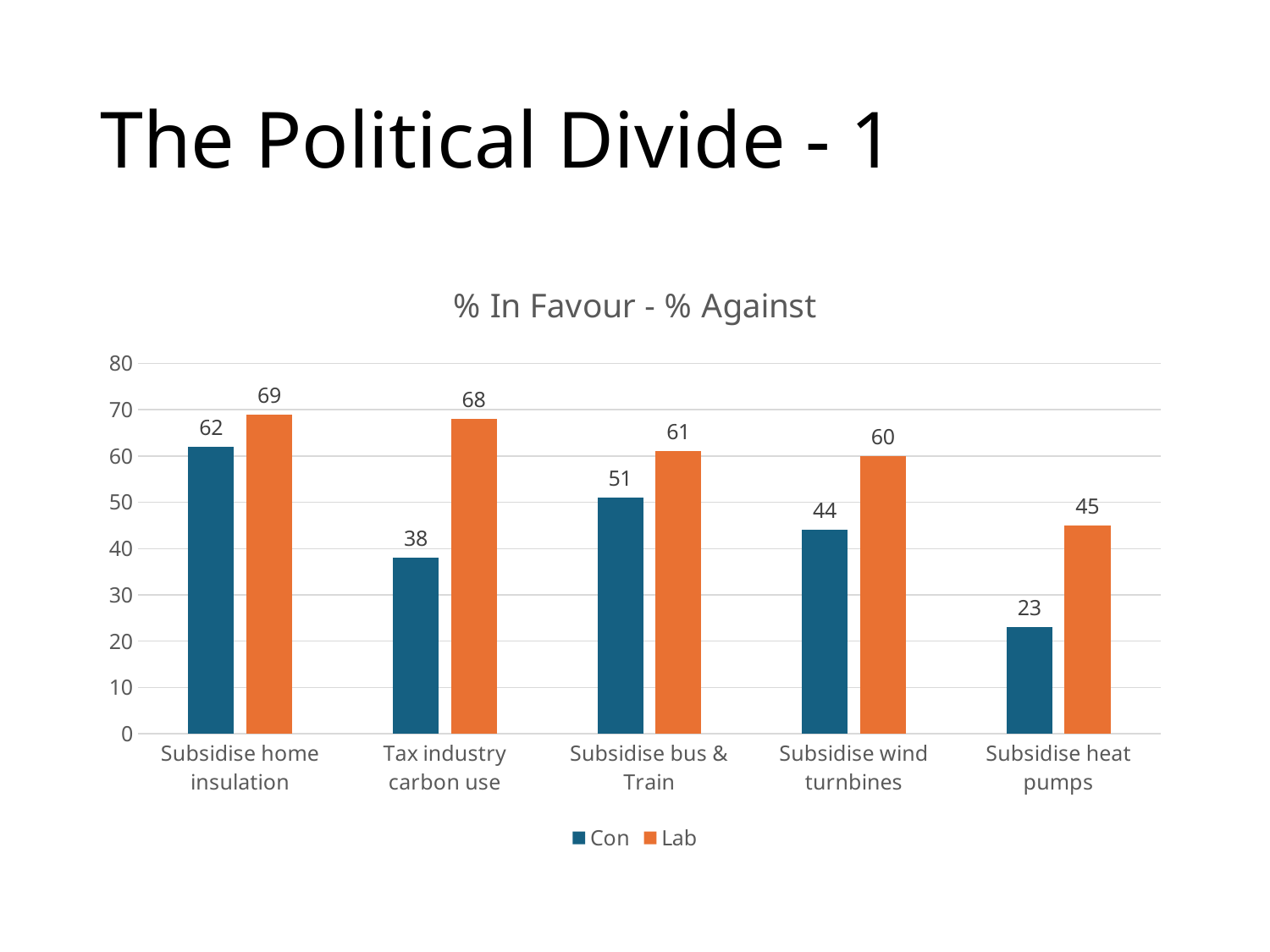
Is the Con value for Subsidise bus & Train greater or less than 40? greater What is the Lab value for Tax industry carbon use? 68 Which category has the lowest Con value? Subsidise heat pumps Which is larger for Subsidise wind turnbines, the Con value or the Lab value? Lab How many series does the legend list? 2 What is the Con value for Subsidise home insulation? 62 Which category has the highest Lab value? Subsidise home insulation What is the Con value for Subsidise heat pumps? 23 What kind of chart is shown on the slide? bar chart What is the difference between the Lab and Con values for Tax industry carbon use? 30 What is the title of the chart? % In Favour - % Against How many categories are shown on the x axis? 5